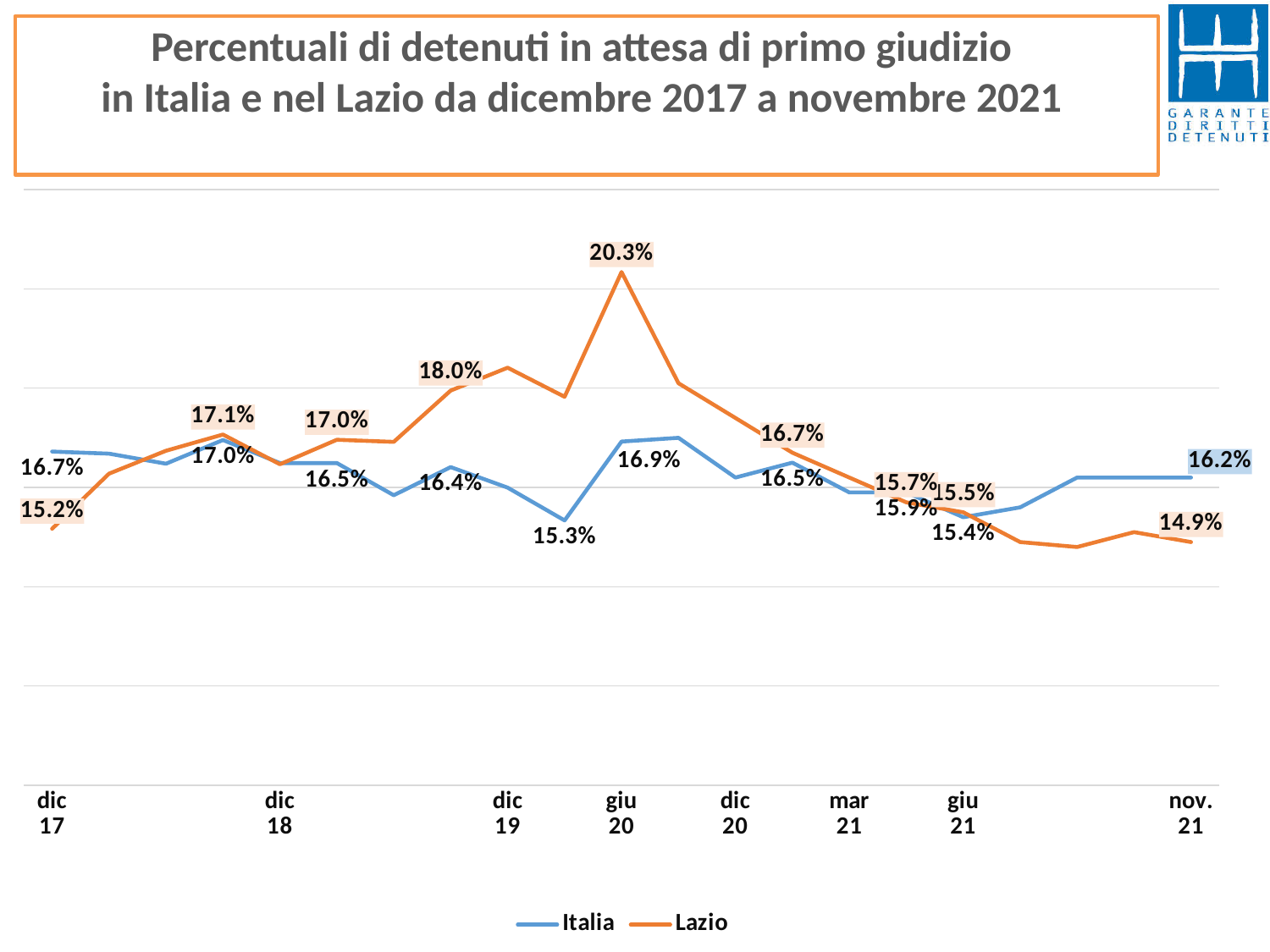
What is the highest labelled value for Lazio? 20.3% What kind of chart is shown on the slide? line chart How many series does the legend list? 2 What is the value for Italia at dic 17? 16.7% Which series has the higher value at giu 20, Italia or Lazio? Lazio What is the value for Lazio at nov. 21? 14.9% What is the value for Lazio at dic 17? 15.2% What is the value for Lazio at giu 20? 20.3% What is the lowest labelled value for Lazio? 14.9% Does the Lazio line rise or fall from giu 20 to nov. 21? fall What is the difference between Italia and Lazio at nov. 21? 1.3 percentage points What is the value for Italia at nov. 21? 16.2%